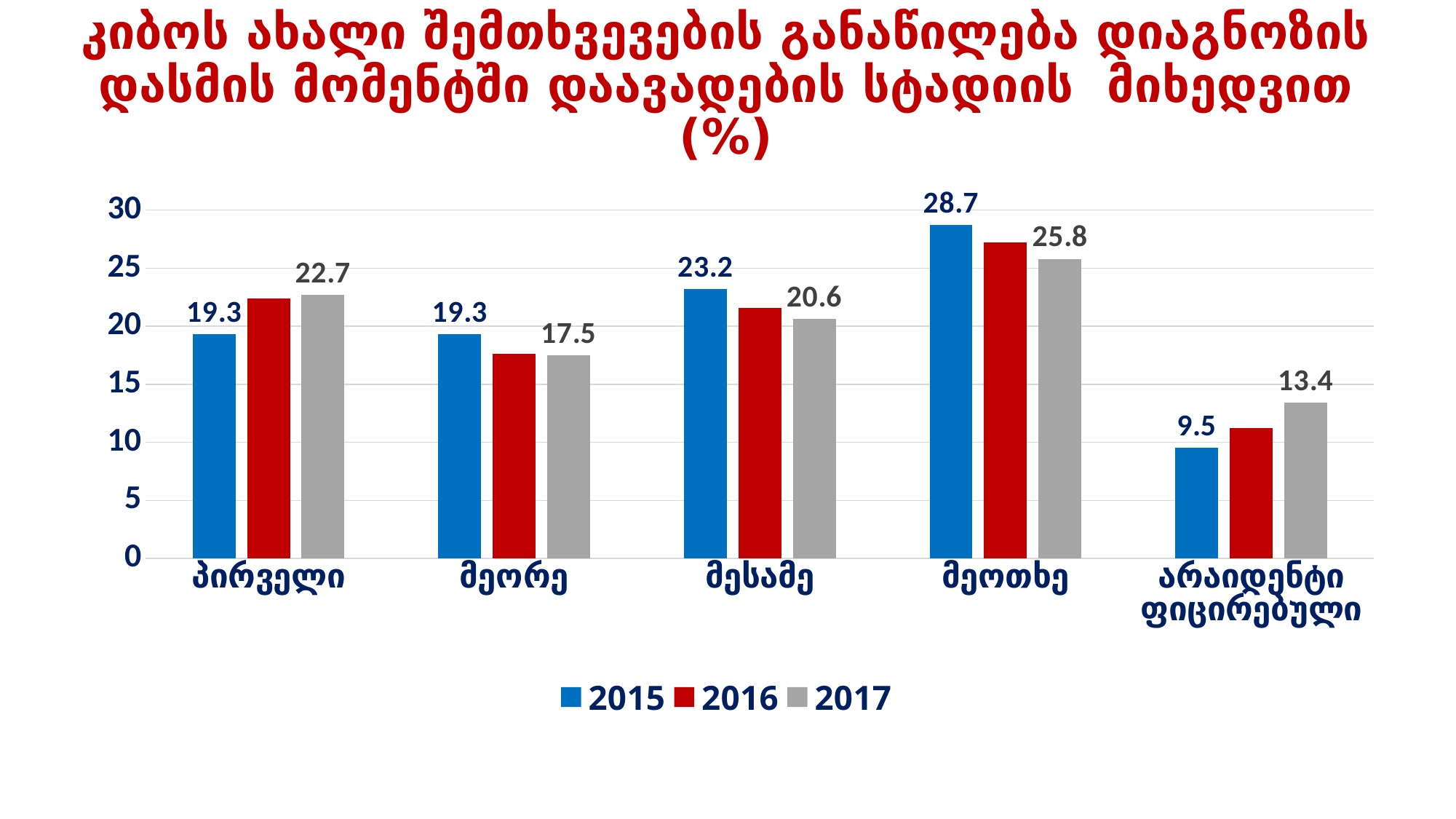
Which category has the lowest 2017 value? არაიდენტიფიცირებული How many series does the legend list? 3 Which colour represents the 2016 series in the legend? red What is the 2017 value for მეორე? 17.5 What is the 2015 value for მეოთხე? 28.7 What is the difference between the 2017 and 2015 values for პირველი? 3.4 How many categories are shown on the x axis? 5 For მესამე, which is larger: the 2015 value or the 2017 value? 2015 Is the 2016 value for მეოთხე greater or less than 25? greater Which category has the highest 2015 value? მეოთხე What kind of chart is shown on the slide? bar chart What is the 2017 value for არაიდენტიფიცირებული? 13.4